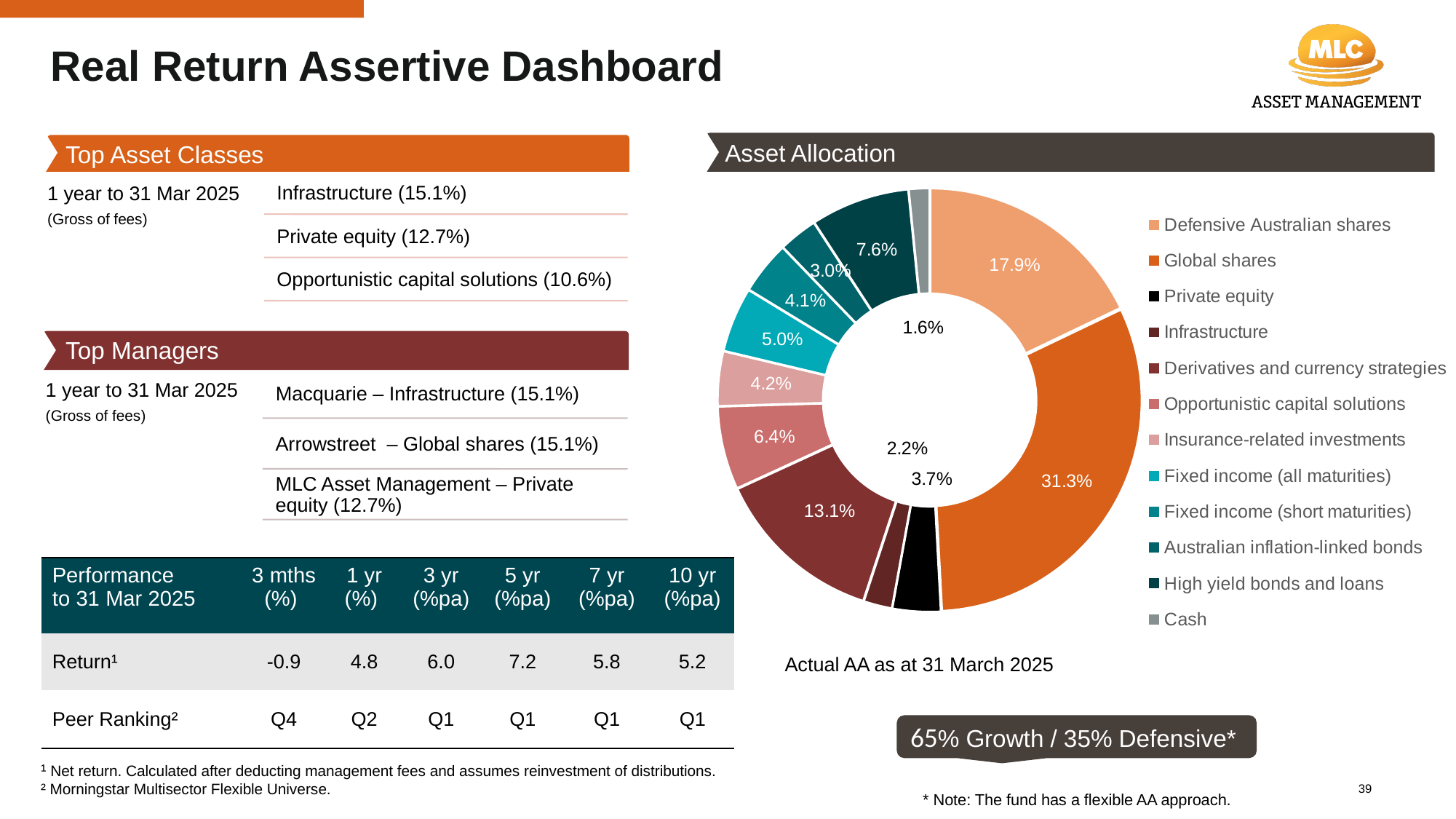
In the Asset Allocation chart, what is the value for Global shares? 31.3% In the Asset Allocation chart, what is the value for High yield bonds and loans? 7.6% In the Asset Allocation chart, what is the value for Fixed income (all maturities)? 5.0% In the Asset Allocation chart, what is the difference between Global shares and Defensive Australian shares? 13.4% Which category has the smallest share in the Asset Allocation chart? Cash In the Asset Allocation chart, what is the value for Defensive Australian shares? 17.9% In the Asset Allocation chart, which is larger: Opportunistic capital solutions or Insurance-related investments? Opportunistic capital solutions How many categories does the legend of the Asset Allocation chart list? 12 In the Asset Allocation chart, what is the value for Derivatives and currency strategies? 13.1% Which category has the largest share in the Asset Allocation chart? Global shares What type of chart is the Asset Allocation chart? Doughnut chart What colour is the Global shares slice in the Asset Allocation chart? Orange